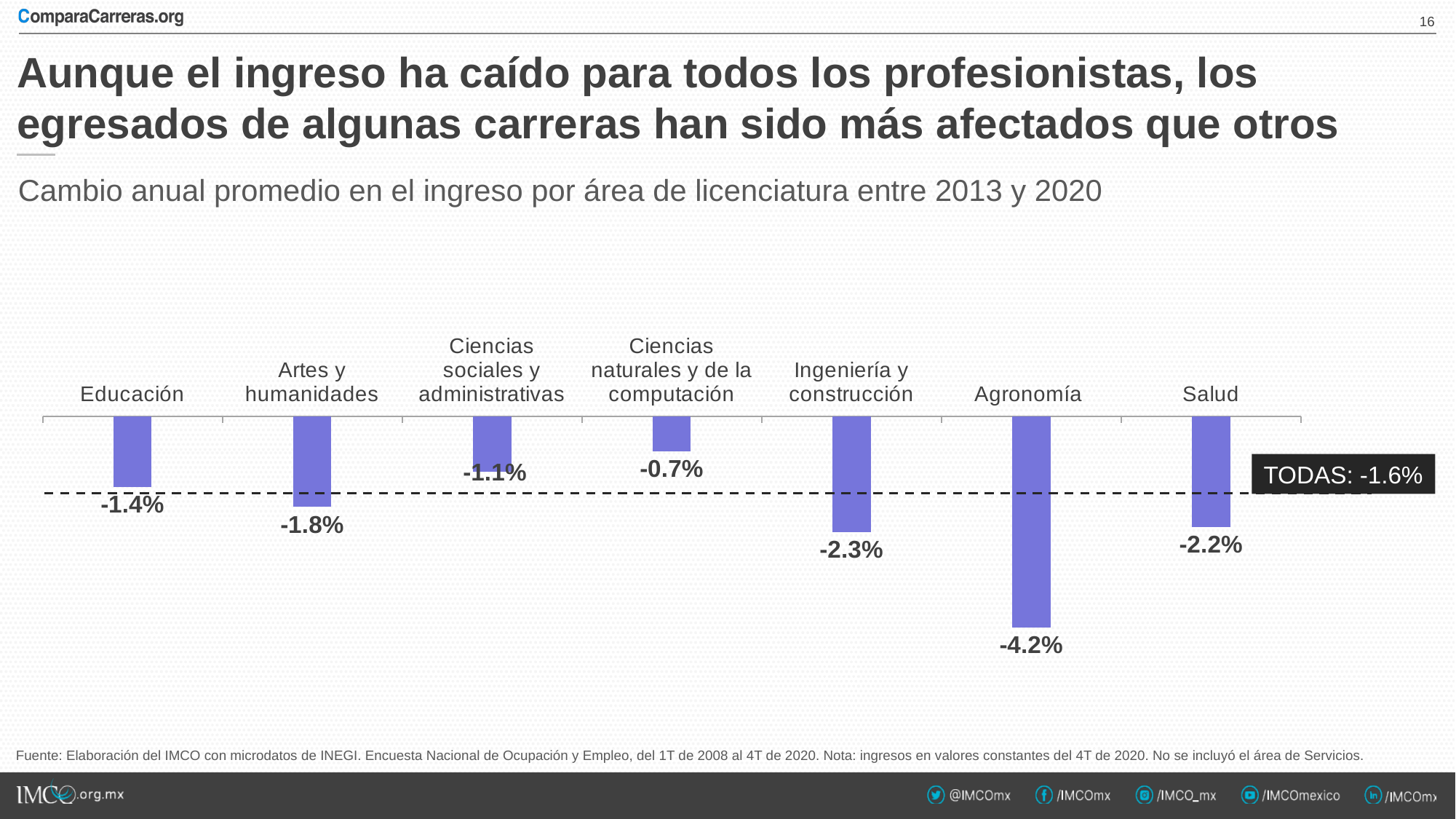
What kind of chart is shown on the slide? Bar chart What is the difference between the values for Agronomía and Educación? 2.8 percentage points Which category shows the smallest decline (the highest value)? Ciencias naturales y de la computación Which has a larger decline, Ingeniería y construcción or Artes y humanidades? Ingeniería y construcción What is the difference between the values for Salud and Ciencias sociales y administrativas? 1.1 percentage points What is the value for Ciencias naturales y de la computación? -0.7% What is the value for Agronomía? -4.2% How many categories (areas) are shown in the chart? 7 What is the value for Salud? -2.2% Which category shows the largest decline (the lowest value)? Agronomía What is the value for Educación? -1.4% What value does the dashed line labelled TODAS represent? -1.6%